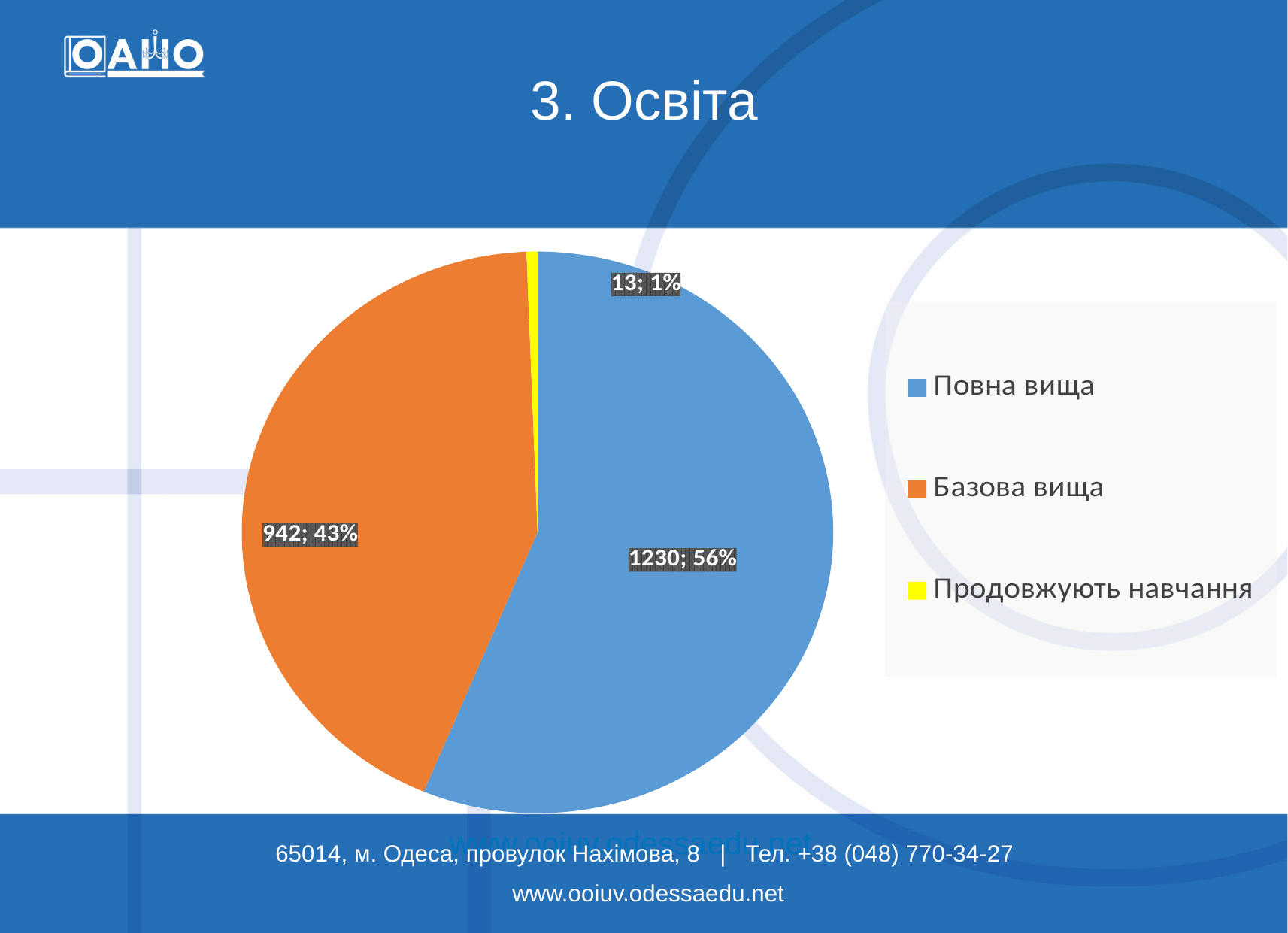
What is the value for Продовжують навчання? 13 Which category has the smallest slice? Продовжують навчання How many entries does the legend list? 3 How many slices does the pie chart have? 3 What is the value for Повна вища? 1230 Which colour represents Продовжують навчання in the pie chart? yellow What share of the pie does Базова вища represent? 43% What share of the pie does Повна вища represent? 56% Which category has the largest slice? Повна вища What is the difference between the values for Повна вища and Базова вища? 288 What is the value for Базова вища? 942 What kind of chart is shown on the slide? pie chart